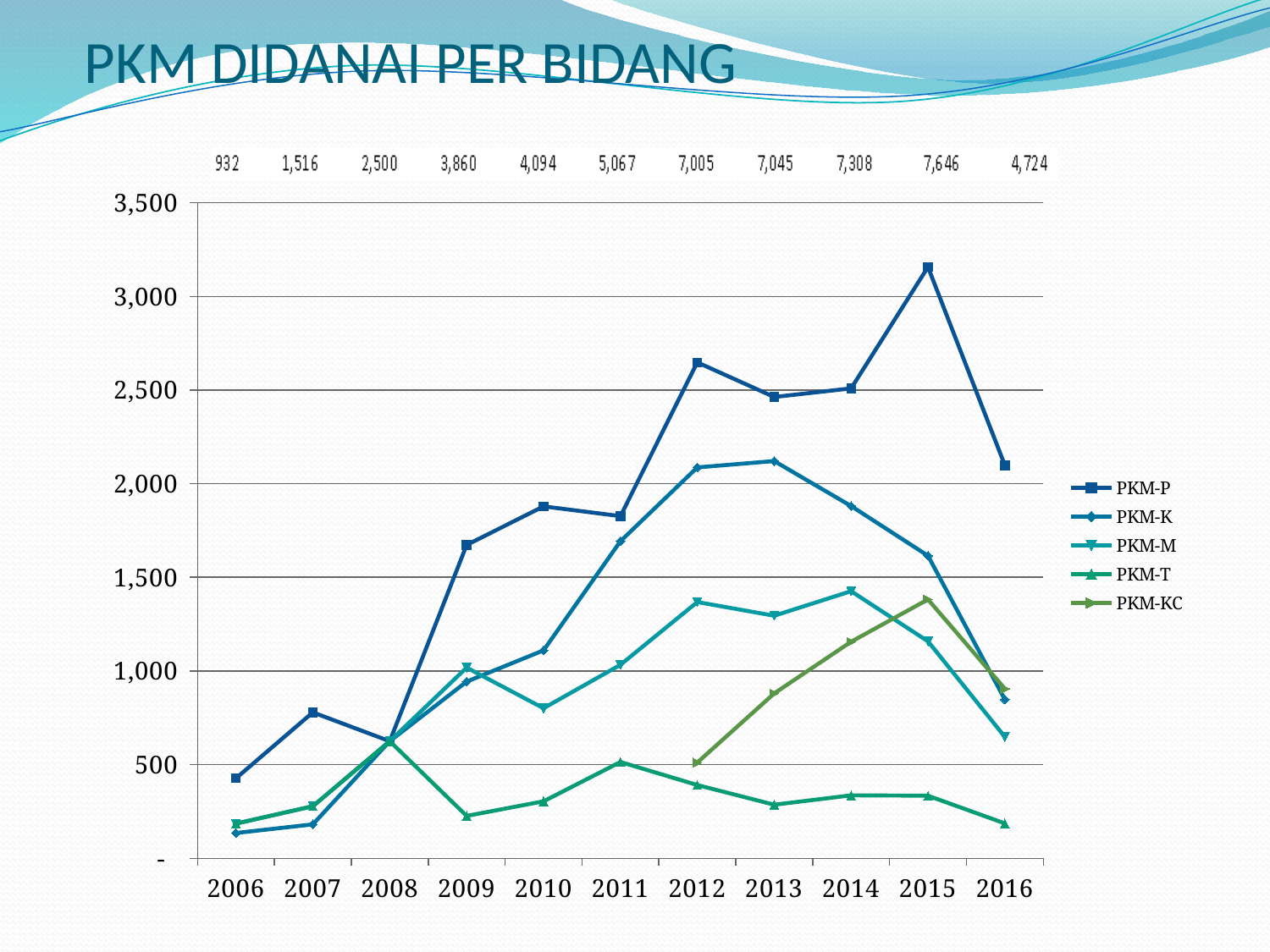
What kind of chart is shown on the slide? line chart Is the value for PKM-KC in 2015 greater or less than 1,000? greater Is the value for PKM-T in 2016 greater or less than 500? less In 2012, which is larger: PKM-P or PKM-K? PKM-P Which series has the lowest value in 2014? PKM-T Is the value for PKM-P in 2015 greater or less than 3,000? greater Which series only begins in 2012? PKM-KC In the row of numbers printed above the chart, what is the value shown for 2015? 7,646 Which series has the highest value in 2015? PKM-P Does the PKM-P line rise or fall from 2015 to 2016? fall How many series does the legend list? 5 How many years are shown along the x axis? 11